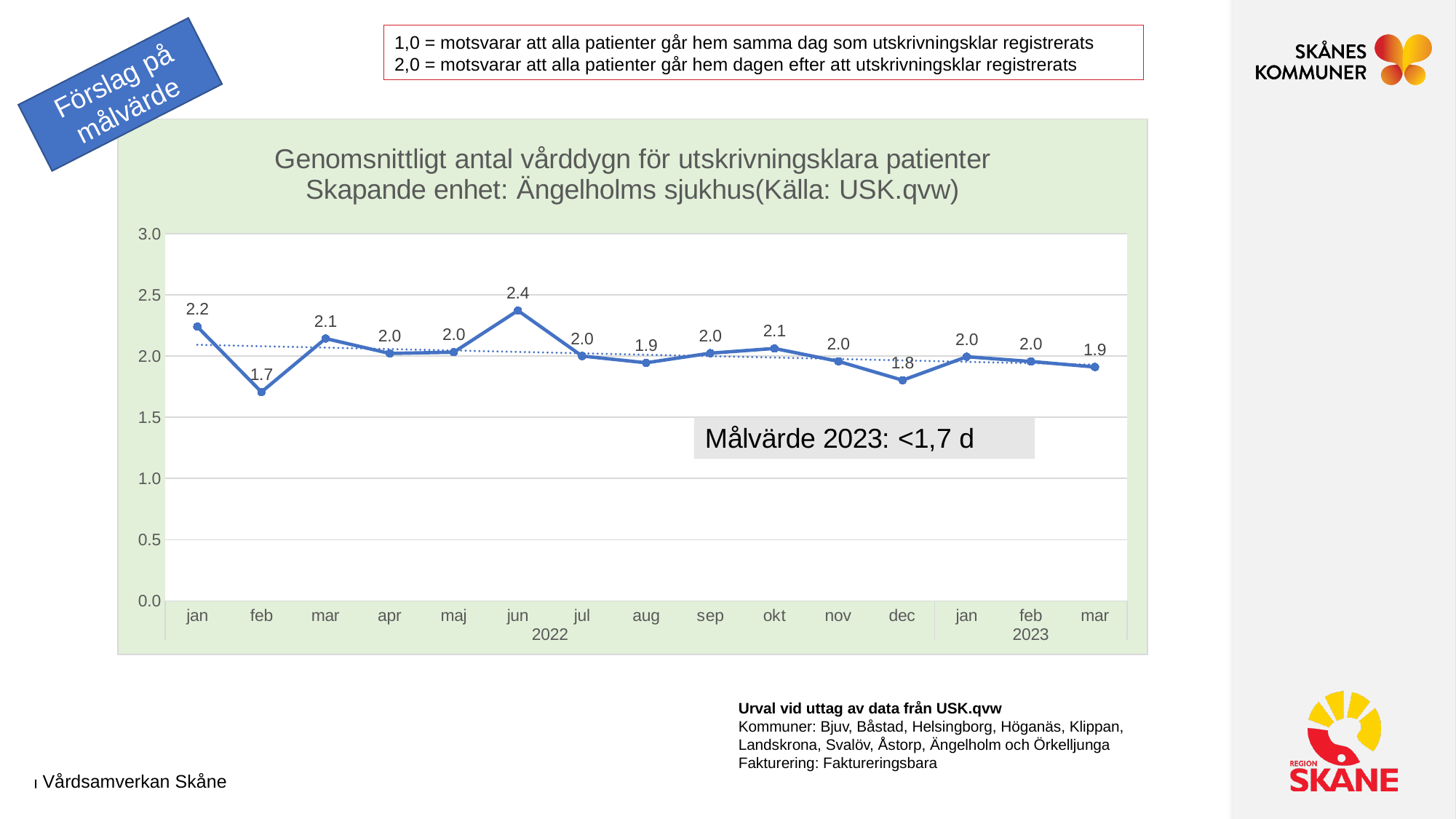
What kind of chart is shown? line chart What is the value for dec 2022? 1.8 What is the value for mar 2023? 1.9 What is the value for jun 2022? 2.4 Which is larger, the value for jan 2022 or the value for dec 2022? jan 2022 What is the value for feb 2022? 1.7 Is the value for jun 2022 greater or less than 2.0? greater How many monthly data points are plotted? 15 What is the difference between the values for jun 2022 and feb 2022? 0.7 Which month has the lowest value? feb 2022 Which month has the highest value? jun 2022 What target value (målvärde) for 2023 is stated on the chart? <1,7 d